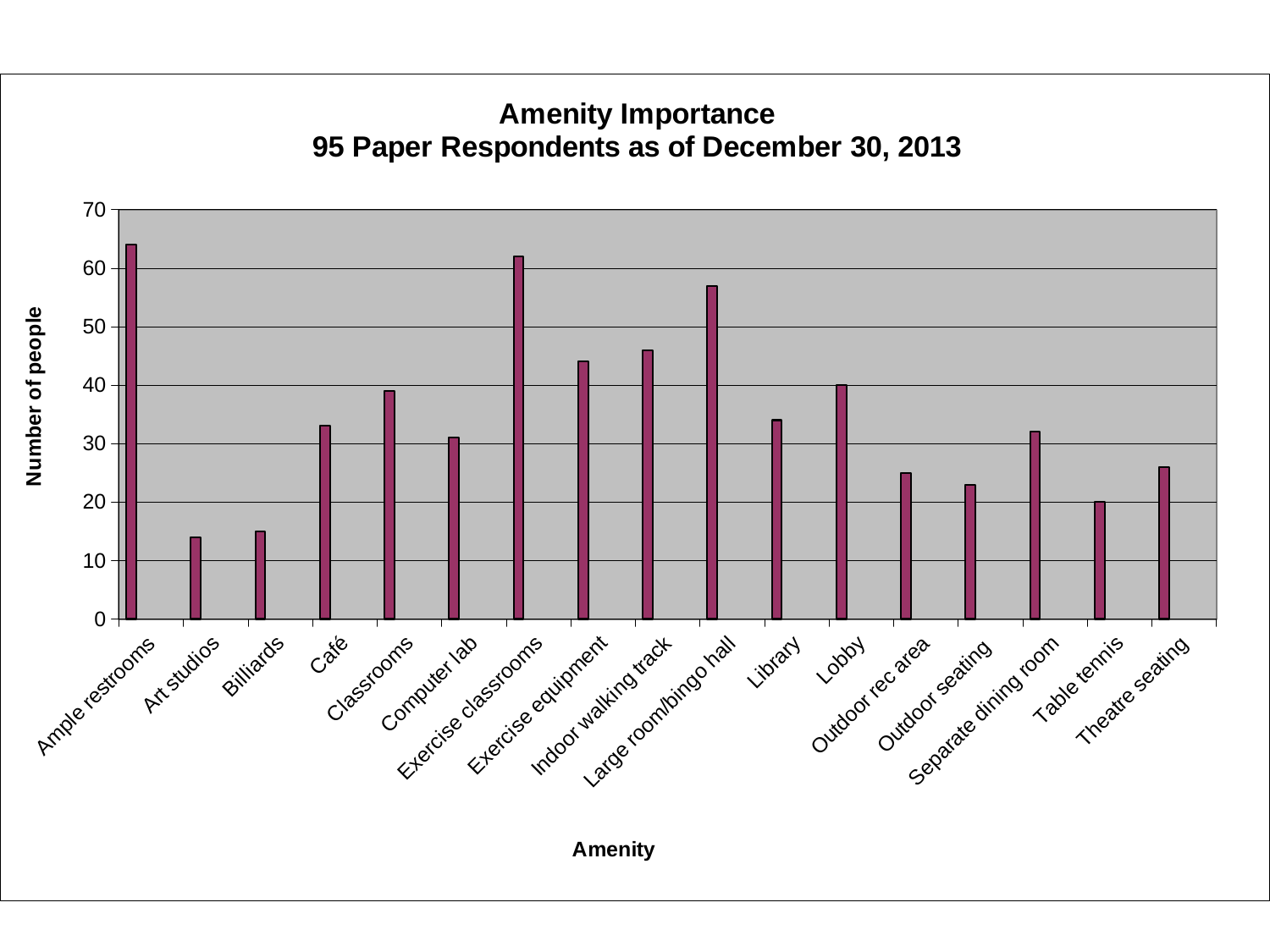
Is the value for Theatre seating greater or less than 20? greater What kind of chart is shown on the slide? bar chart Is the value for Ample restrooms greater or less than 60? greater Is the value for Large room/bingo hall greater or less than 50? greater Which has a higher value, Café or Classrooms? Classrooms What is the title of the vertical axis? Number of people How many amenities are plotted on the x axis? 17 Which has a higher value, Exercise classrooms or Large room/bingo hall? Exercise classrooms Which has a higher value, Outdoor rec area or Separate dining room? Separate dining room